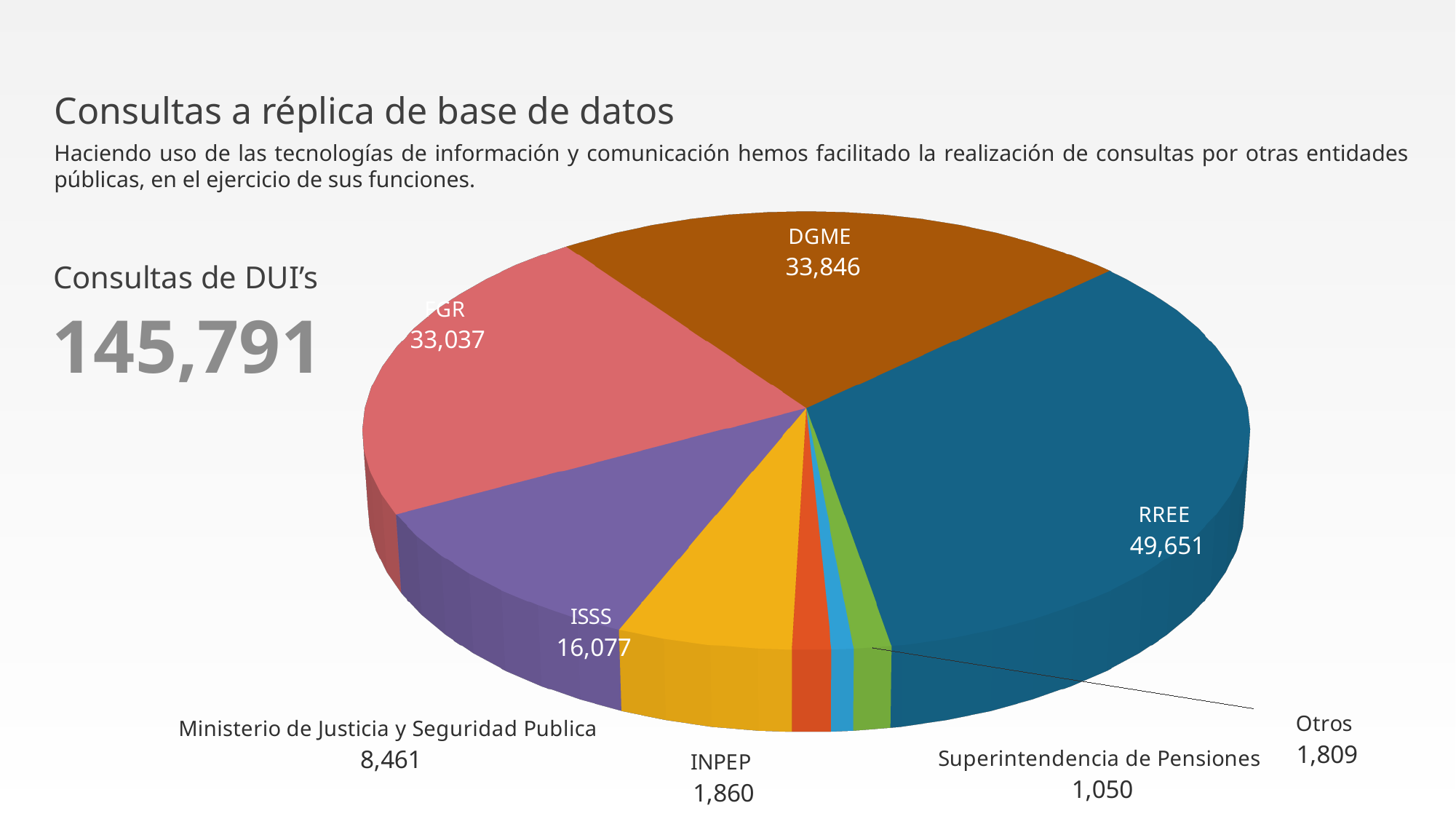
What is the value for Superintendencia de Pensiones? 1,050 What kind of chart is shown on the slide? pie chart What is the difference between the values for ISSS and Ministerio de Justicia y Seguridad Publica? 7,616 What is the value for DGME? 33,846 What is the difference between the values for RREE and DGME? 15,805 What is the value for RREE? 49,651 How many slices does the pie chart have? 8 Which category has the largest slice of the pie? RREE Which category has the smallest slice of the pie? Superintendencia de Pensiones What total number of Consultas de DUI's is shown on the slide? 145,791 What is the value for Ministerio de Justicia y Seguridad Publica? 8,461 Which is larger, DGME or FGR? DGME